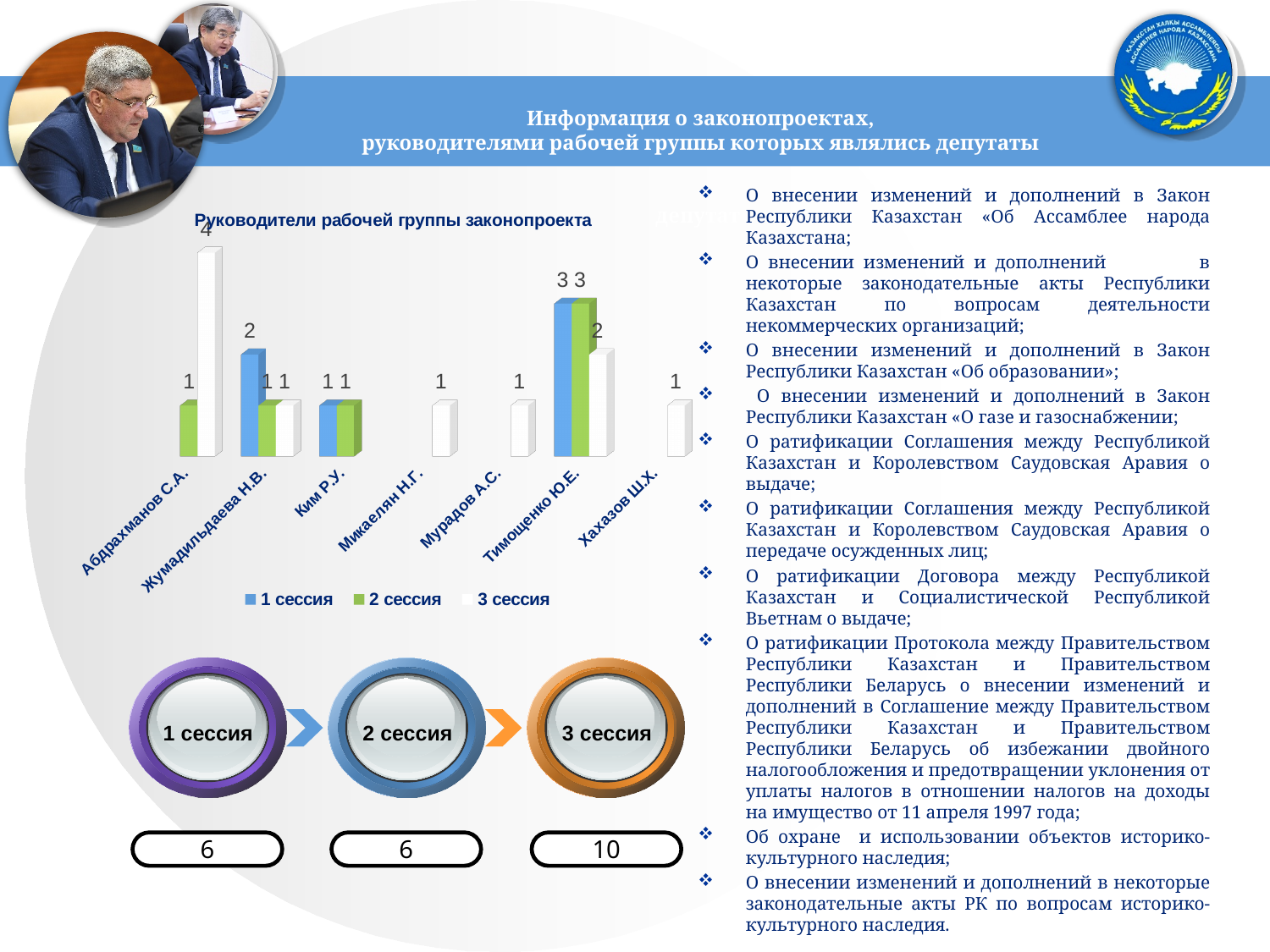
What is the value for Тимощенко Ю.Е. in the 3 сессия series? 2 What is the value for Тимощенко Ю.Е. in the 1 сессия series? 3 How many deputies (categories) are shown on the x axis of the chart? 7 How many series does the chart legend list? 3 What is the difference between the 3 сессия value for Абдрахманов С.А. and the 3 сессия value for Тимощенко Ю.Е.? 2 What is the title of the chart? Руководители рабочей группы законопроекта What is the value for Абдрахманов С.А. in the 3 сессия series? 4 Which colour represents the 2 сессия series in the chart? green What type of chart is shown on the slide? bar chart Which is larger: the 1 сессия value for Жумадильдаева Н.В. or the 1 сессия value for Тимощенко Ю.Е.? Тимощенко Ю.Е. What is the value for Жумадильдаева Н.В. in the 1 сессия series? 2 Which deputy has the highest single bar in the chart? Абдрахманов С.А.